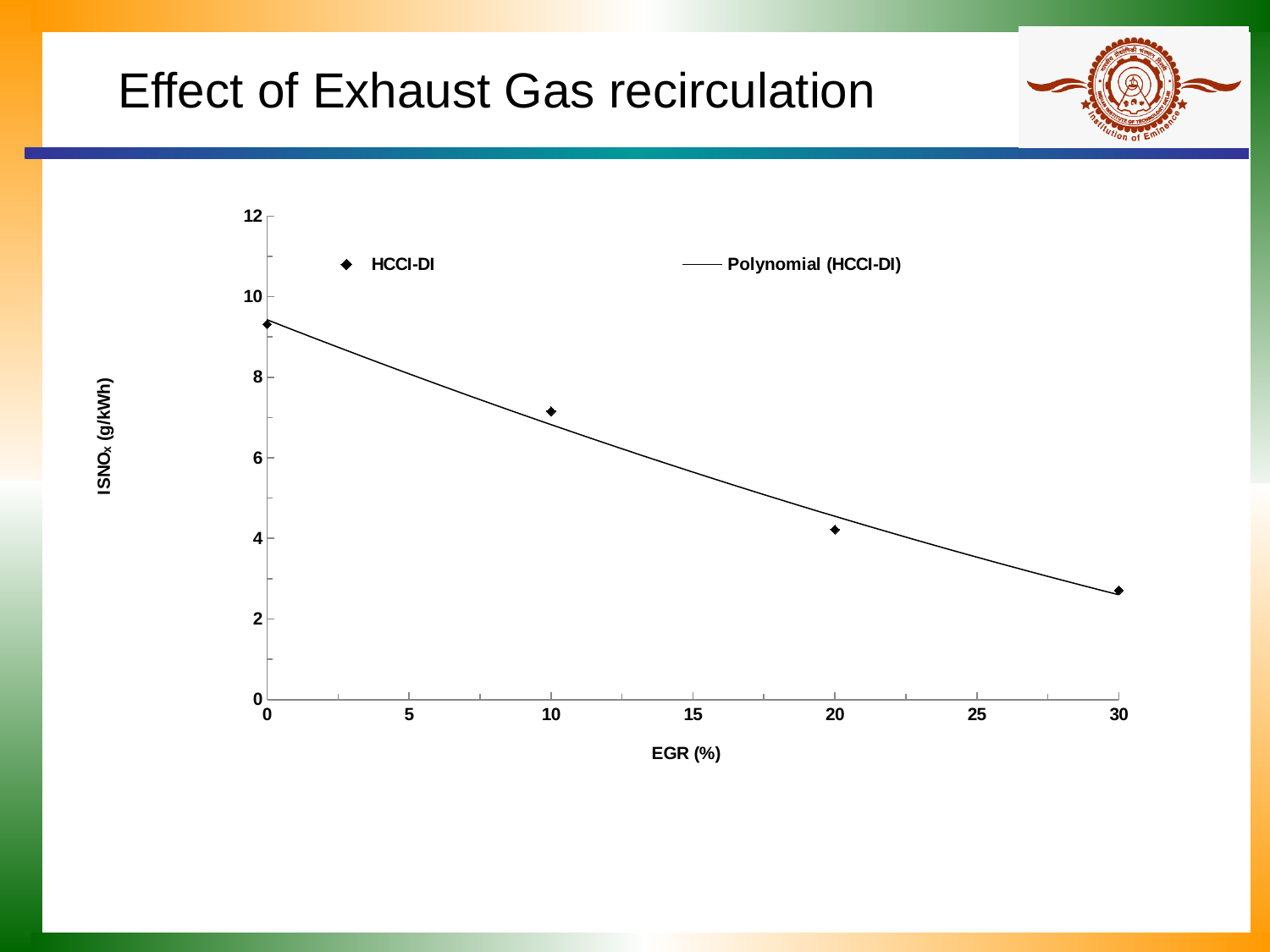
How many HCCI-DI data points are plotted on the chart? 4 How many entries does the chart legend list? 2 Is the ISNOx value at 10% EGR greater or less than 6? greater Which has the larger ISNOx value, 10% EGR or 30% EGR? 10% EGR Do the ISNOx values rise or fall as EGR increases along the x axis? fall Is the ISNOx value at 20% EGR greater or less than 6? less At which EGR value is ISNOx highest? 0 What is the label of the y axis? ISNOx (g/kWh) What kind of chart is shown on the slide? scatter chart What is the label of the x axis? EGR (%) At which EGR value is ISNOx lowest? 30 Is the ISNOx value at 0% EGR greater or less than 8? greater